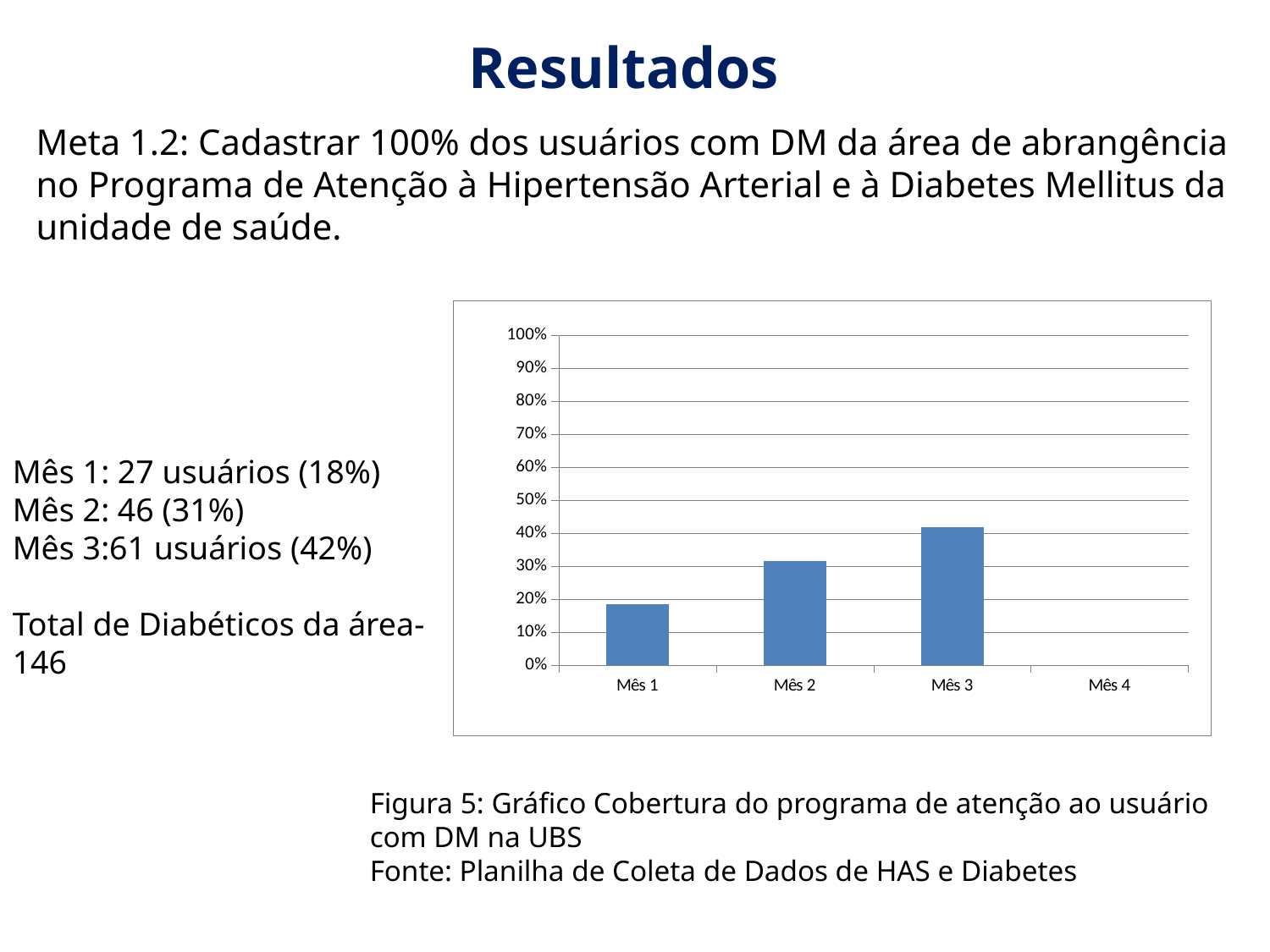
Is the bar for Mês 3 greater or less than 30%? greater What is the highest value shown on the chart's y axis? 100% Among Mês 1, Mês 2 and Mês 3, which has the shortest bar? Mês 1 Which month on the x axis has no bar plotted? Mês 4 Is the bar for Mês 2 greater or less than 40%? less How many categories are shown on the x axis of the chart? 4 Do the bars rise or fall from Mês 1 to Mês 3? rise Which month has the tallest bar in the chart? Mês 3 Which is larger, the bar for Mês 2 or the bar for Mês 1? Mês 2 Is the bar for Mês 3 greater or less than 50%? less What kind of chart is shown on the slide? bar chart